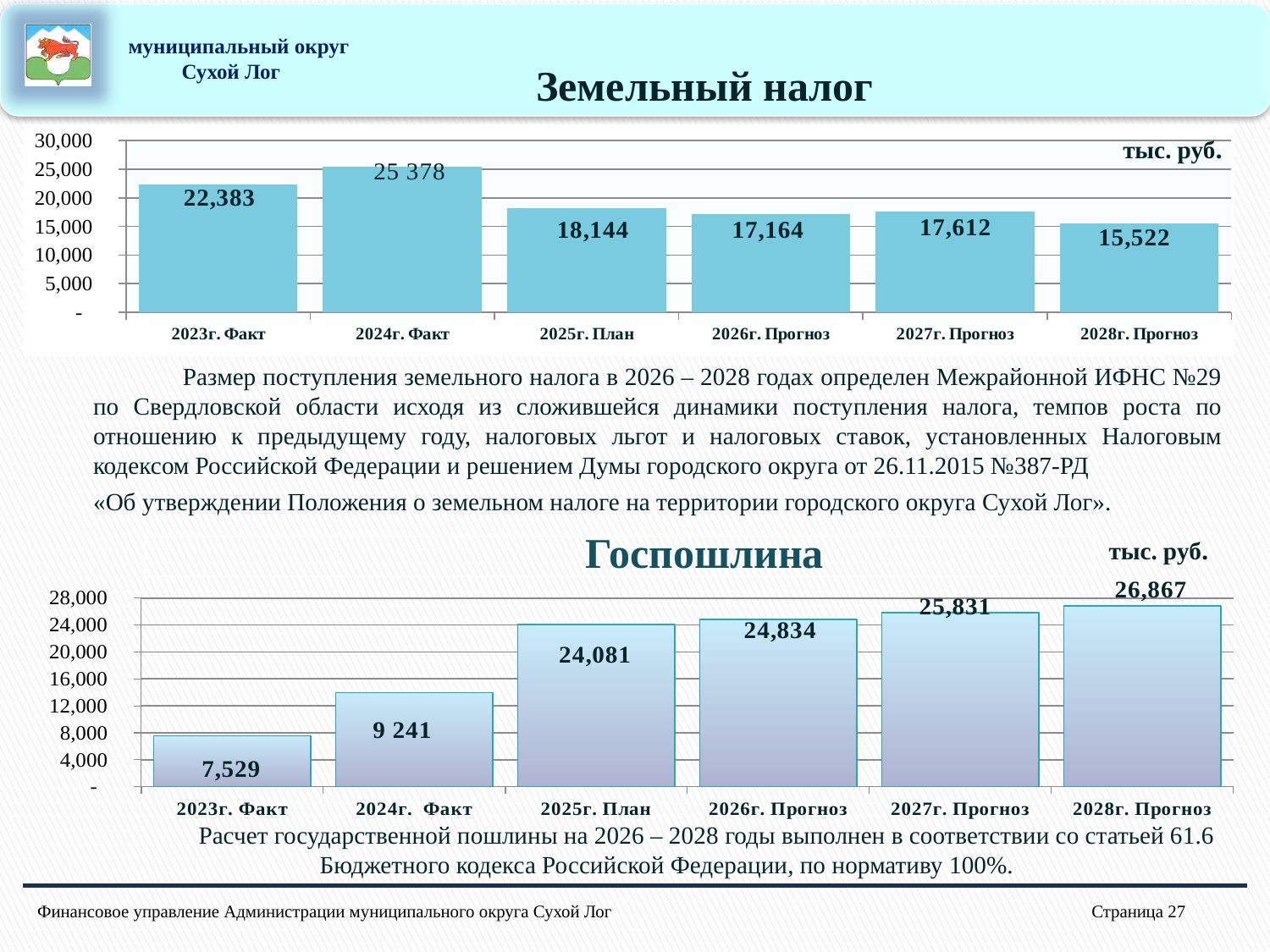
In the Госпошлина chart, what is the value for 2023г. Факт? 7,529 In the Госпошлина chart, which category has the highest value? 2028г. Прогноз In the Земельный налог chart, what is the value for 2028г. Прогноз? 15,522 In the Земельный налог chart, which is larger: the value for 2026г. Прогноз or 2027г. Прогноз? 2027г. Прогноз In the Земельный налог chart, what is the difference between the values for 2023г. Факт and 2026г. Прогноз? 5,219 In the Госпошлина chart, do the values rise or fall from 2025г. План to 2028г. Прогноз? rise In the Земельный налог chart, which category has the lowest value? 2028г. Прогноз In the Госпошлина chart, what is the value for 2027г. Прогноз? 25,831 What kind of chart is the Земельный налог chart? bar chart In the Земельный налог chart, which category has the highest value? 2024г. Факт In the Земельный налог chart, what is the value for 2025г. План? 18,144 How many categories are shown in the Госпошлина chart? 6